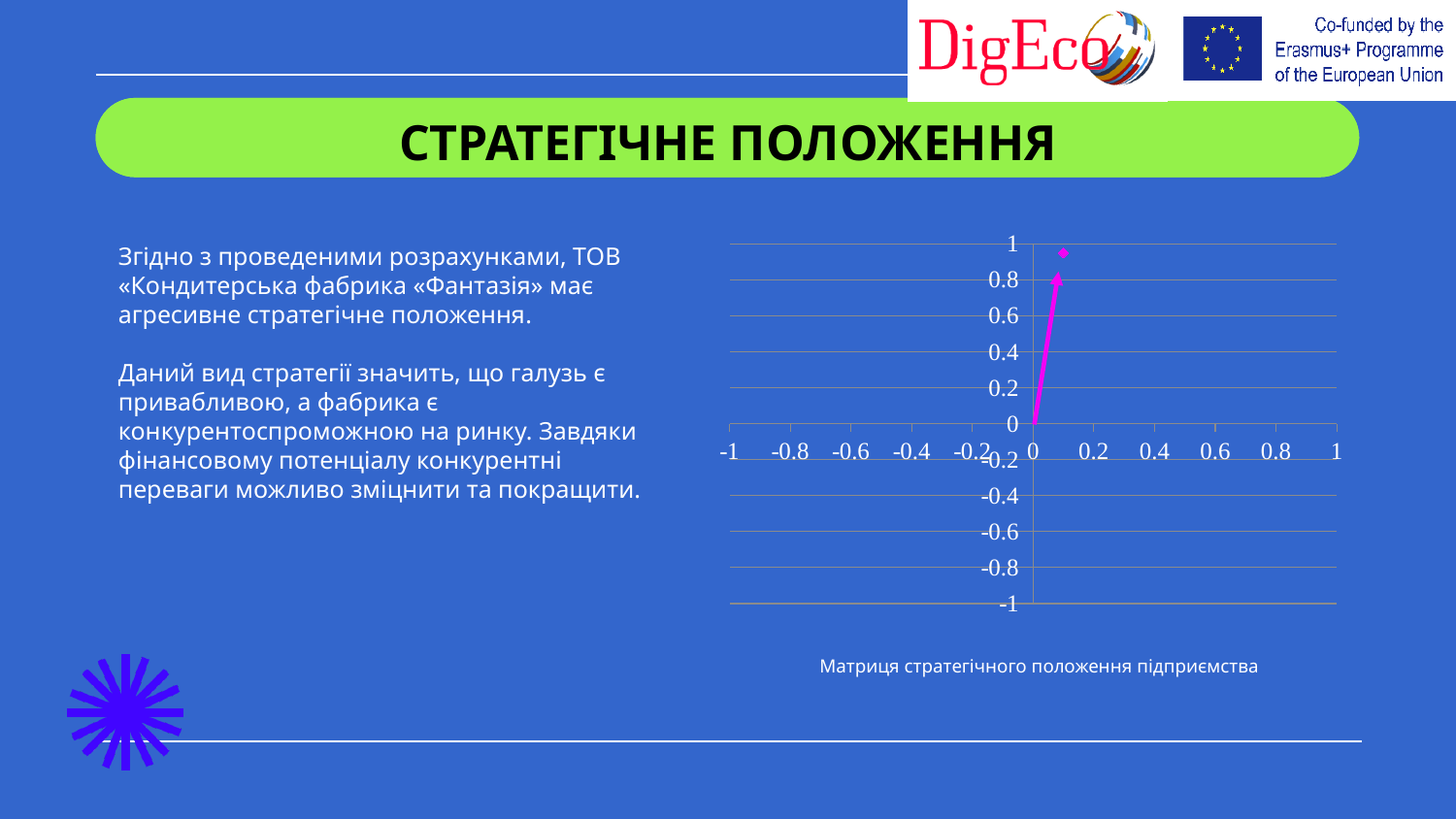
What is the lowest value shown on the chart's y axis? -1 Is the y value of the plotted point greater or less than 0.6? greater Is the x value of the plotted point greater or less than 0.2? less Is the y value of the plotted point greater or less than 0.8? greater In which quadrant of the chart does the plotted point lie? upper right What is the highest value shown on the chart's x axis? 1 How many data points are plotted on the chart? 1 What kind of chart is shown on the slide? scatter chart